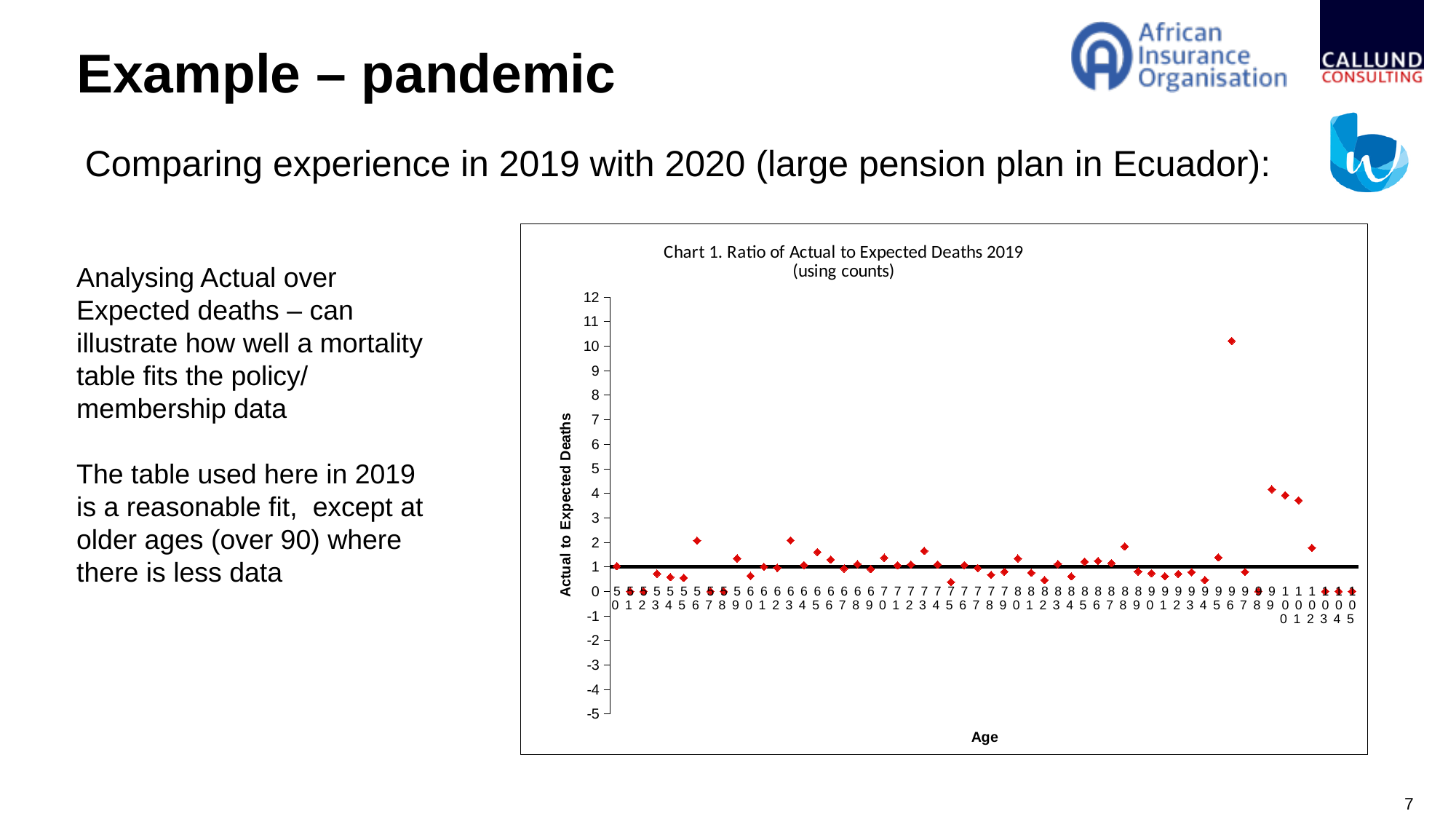
Is the value for age 100 greater or less than 3? greater What kind of chart is shown on the slide? Scatter chart What is the lowest value shown on the vertical axis? -5 What is the label on the vertical axis of the chart? Actual to Expected Deaths Is the value for age 103 greater or less than 1? less What is the title of the chart? Chart 1. Ratio of Actual to Expected Deaths 2019 (using counts) Is the value for age 92 greater or less than 1? less At which age is the ratio of actual to expected deaths highest? 96 Which has the larger value, age 101 or age 103? Age 101 Which has the larger value, age 96 or age 100? Age 96